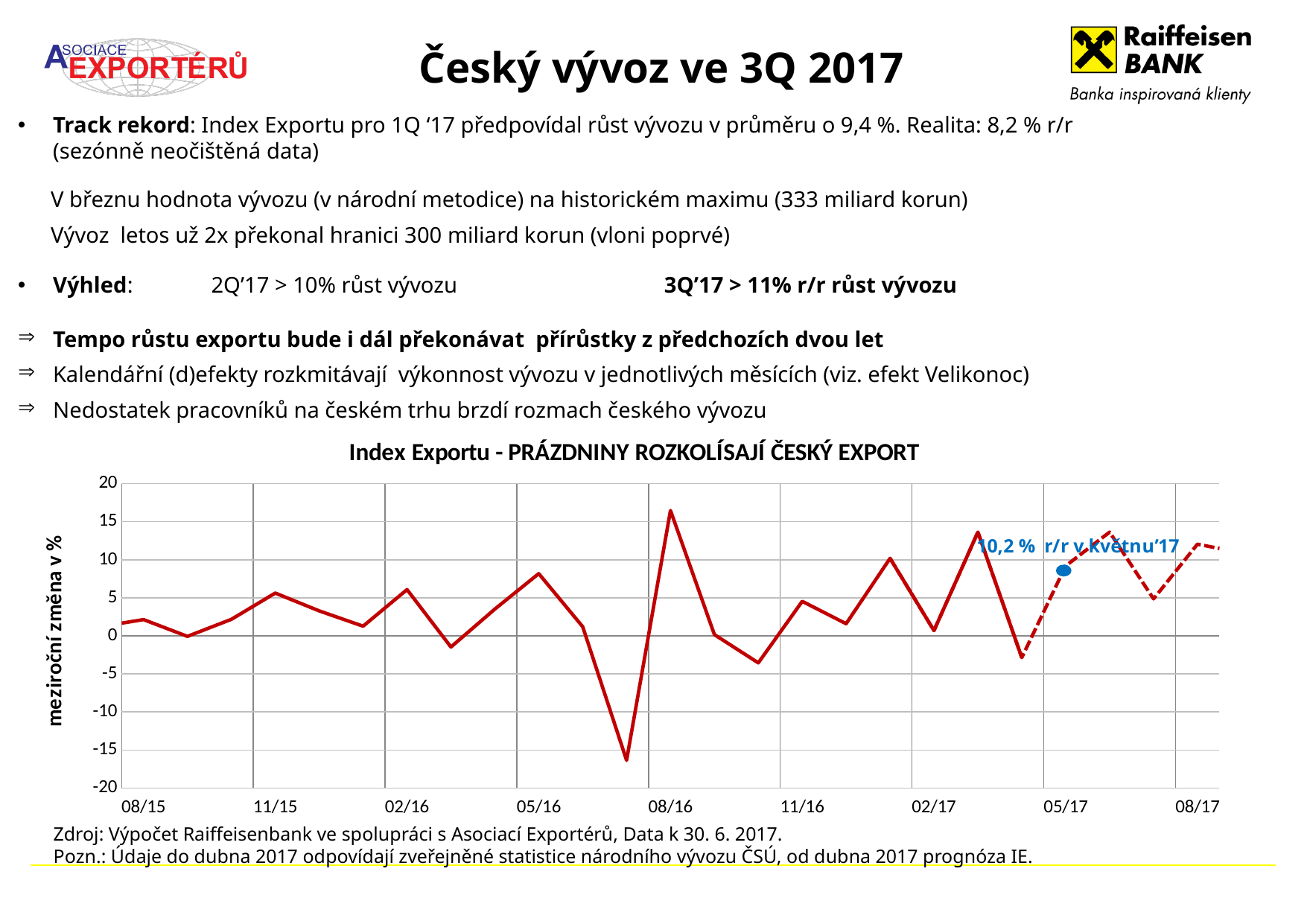
Is the value for 05/17 greater or less than 5? greater Is the highest point on the line greater or less than 15? greater Is the value for 08/15 greater or less than 5? less What is the year-on-year change labelled on the chart for May 2017 (05/17)? 10,2 % What is the title of the chart? Index Exportu - PRÁZDNINY ROZKOLÍSAJÍ ČESKÝ EXPORT How many month labels are shown on the x axis? 9 Which month is the data label "10,2 % r/r" attached to? květen '17 (05/17) What kind of chart is shown on the slide? line chart What is the label of the y axis? meziroční změna v %